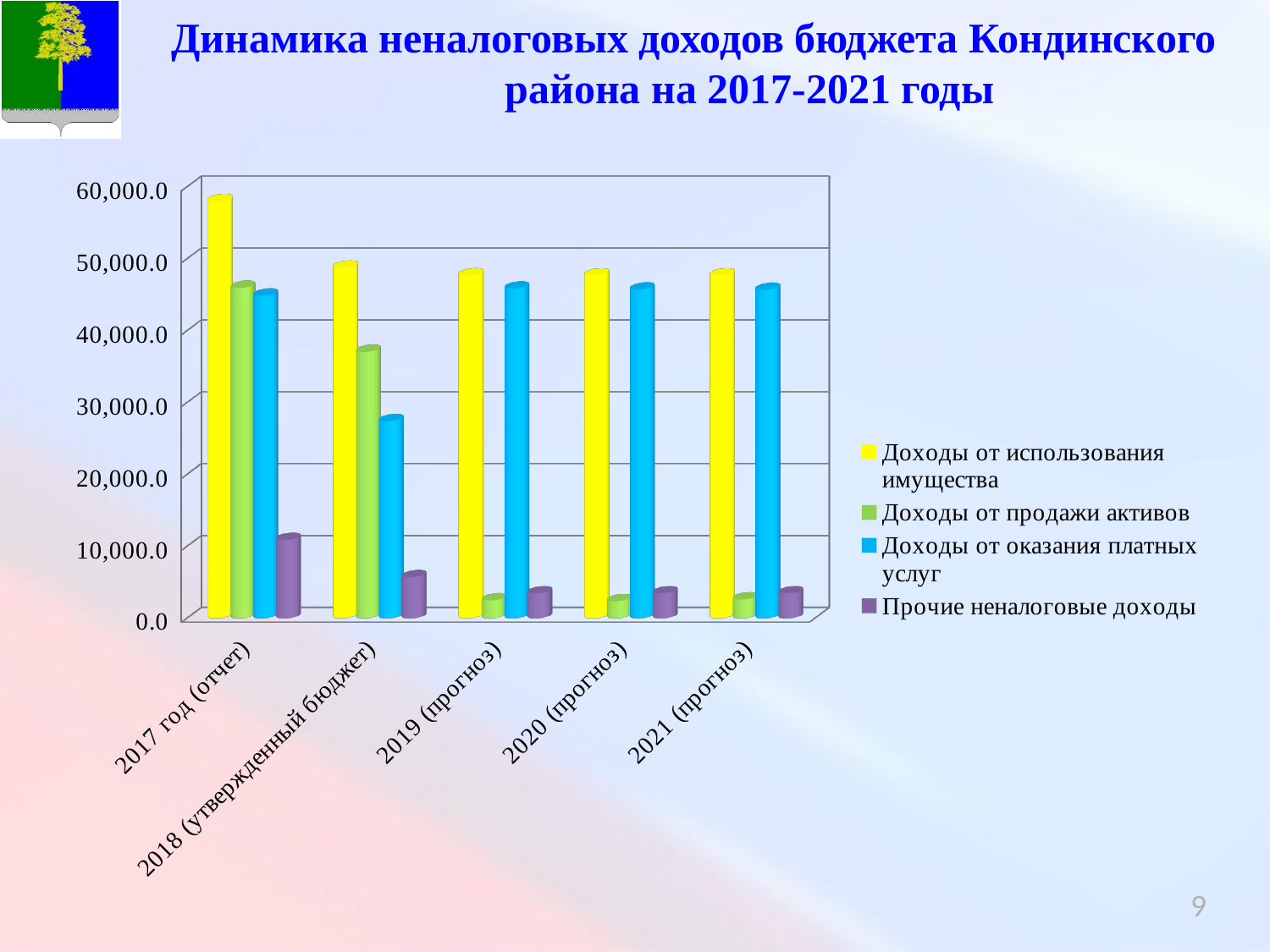
Is the value for Доходы от оказания платных услуг in 2019 (прогноз) greater or less than 40,000.0? greater Is the value for Доходы от оказания платных услуг in 2018 (утвержденный бюджет) greater or less than 30,000.0? less How many categories are shown on the x axis? 5 Is the value for Прочие неналоговые доходы in 2017 год (отчет) greater or less than 5,000.0? greater Which is larger: Доходы от продажи активов in 2017 год (отчет) or in 2018 (утвержденный бюджет)? 2017 год (отчет) What colour represents Доходы от оказания платных услуг in the chart? blue Do the values for Доходы от продажи активов rise or fall from 2017 год (отчет) to 2019 (прогноз)? fall Which series has the lowest value in 2018 (утвержденный бюджет)? Прочие неналоговые доходы In which category is Доходы от использования имущества highest? 2017 год (отчет) What kind of chart is shown on the slide? bar chart How many series does the legend list? 4